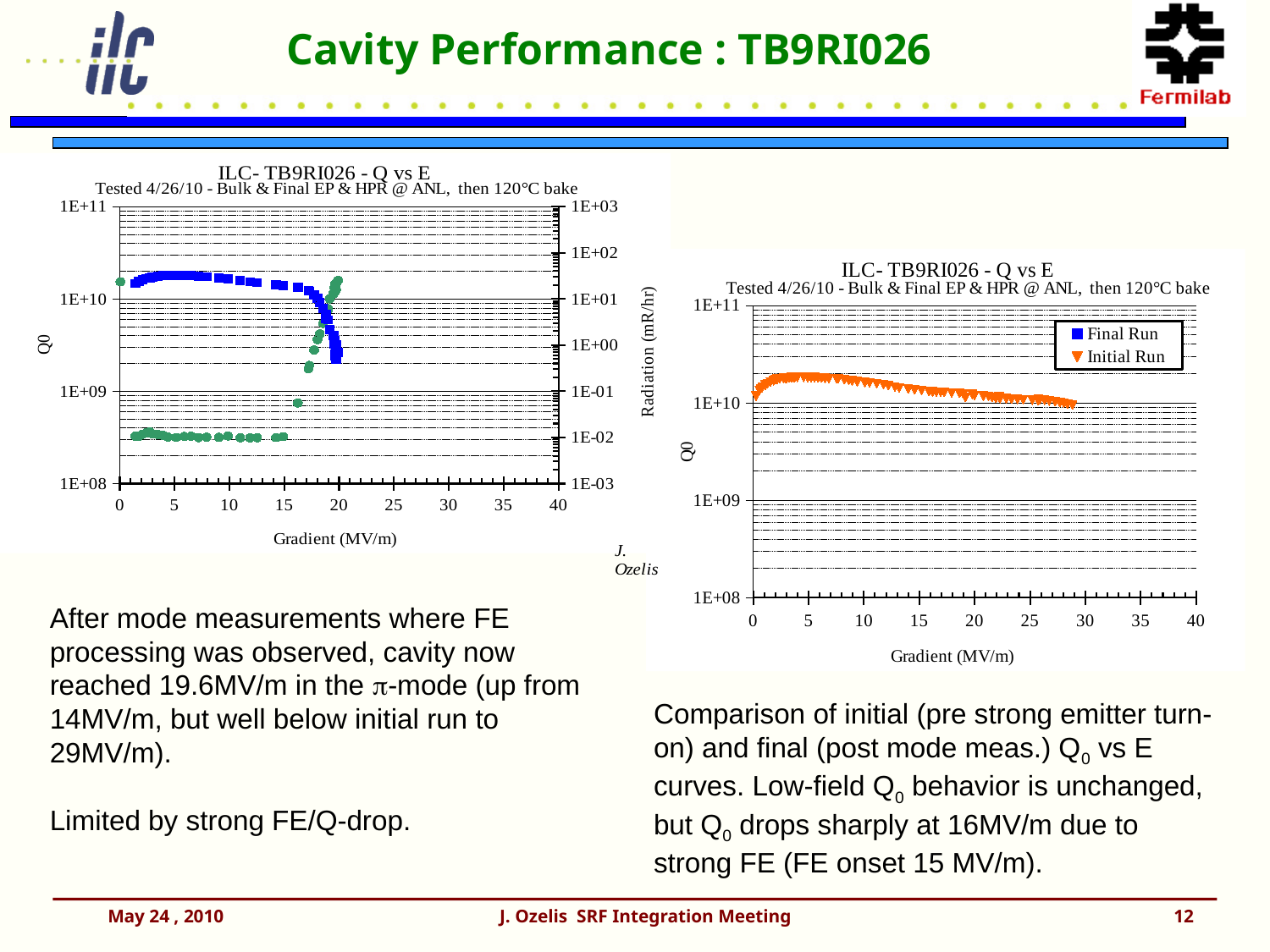
What is the highest gradient tick shown on the x axis of the chart on the left? 40 How many series does the legend of the chart on the right list? 2 What kind of chart is the chart on the left of the slide? scatter chart In the chart on the right, does the Initial Run Q0 rise or fall as the gradient increases beyond about 5 MV/m? fall In the chart on the left, does Q0 rise or fall as the gradient approaches 20 MV/m? fall In the chart on the right, is the Final Run Q0 at a gradient of 20 MV/m greater or less than 1E+10? less What is the x-axis label of the chart on the right? Gradient (MV/m) In the chart on the right, is the Initial Run Q0 at a gradient of 25 MV/m greater or less than 1E+09? greater In the chart on the right, which series extends to the higher gradient, Final Run or Initial Run? Initial Run What are the two series named in the legend of the chart on the right? Final Run and Initial Run In the chart on the left, is the radiation value at a gradient of 5 MV/m greater or less than 1E-01 mR/hr? less